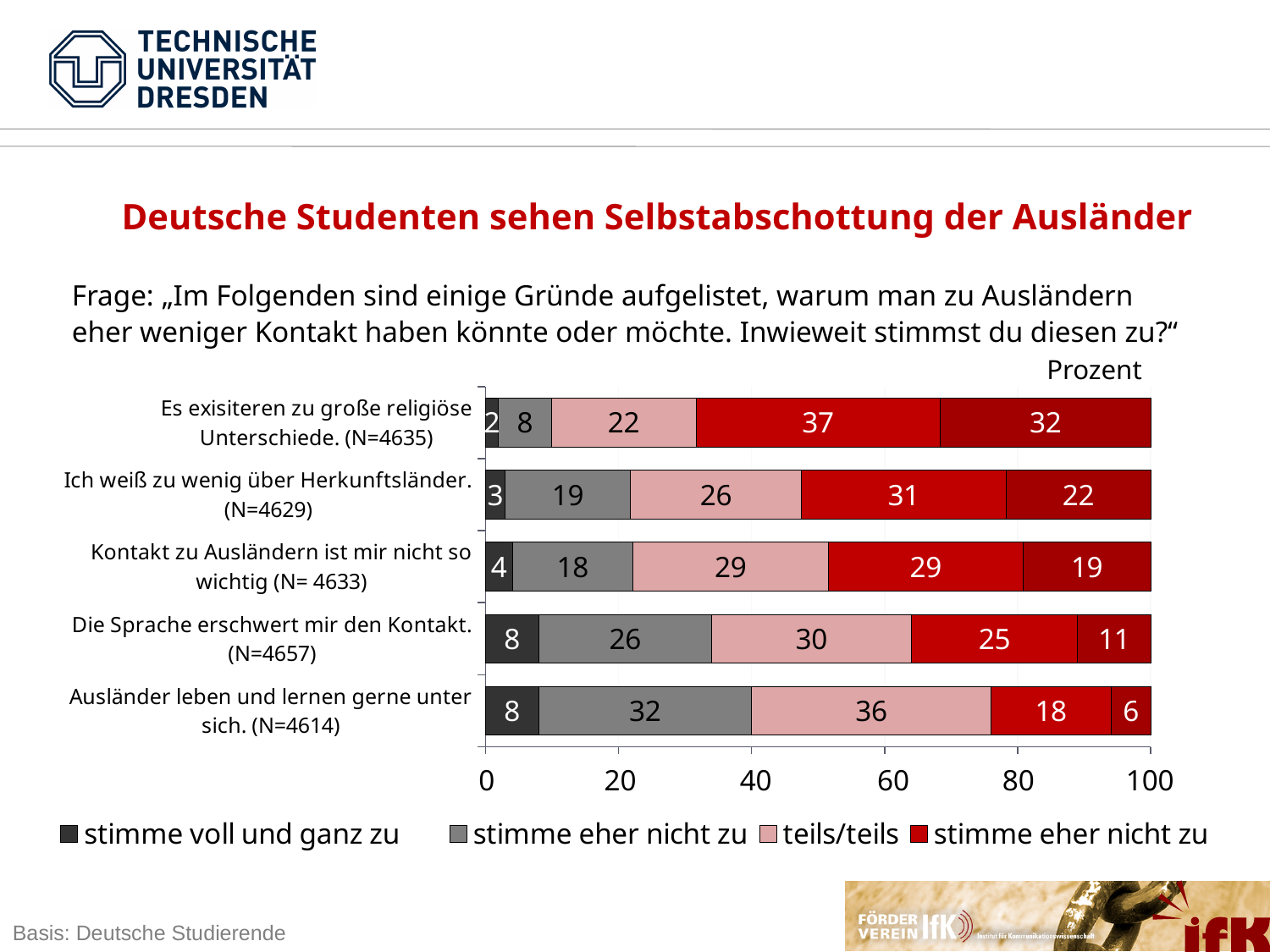
Is the pink (teils/teils) segment larger for "Kontakt zu Ausländern ist mir nicht so wichtig" or for "Ich weiß zu wenig über Herkunftsländer"? Kontakt zu Ausländern ist mir nicht so wichtig How many entries does the chart legend list? 4 What is the difference between the bright red segment for "Es exisiteren zu große religiöse Unterschiede" and the bright red segment for "Die Sprache erschwert mir den Kontakt"? 12 Which statement has the smallest dark red (rightmost) segment? Ausländer leben und lernen gerne unter sich What kind of chart is shown on the slide? Stacked bar chart What unit label is shown above the chart's x axis? Prozent What is the value of the darkest (leftmost) segment for "Die Sprache erschwert mir den Kontakt"? 8 What is the total of all segments in the bar for "Die Sprache erschwert mir den Kontakt"? 100 How many statements (categories) are plotted in the chart? 5 What is the value of the pink (teils/teils) segment for "Ausländer leben und lernen gerne unter sich"? 36 What is the value of the bright red segment for "Es exisiteren zu große religiöse Unterschiede"? 37 Which statement has the largest dark red (rightmost) segment? Es exisiteren zu große religiöse Unterschiede